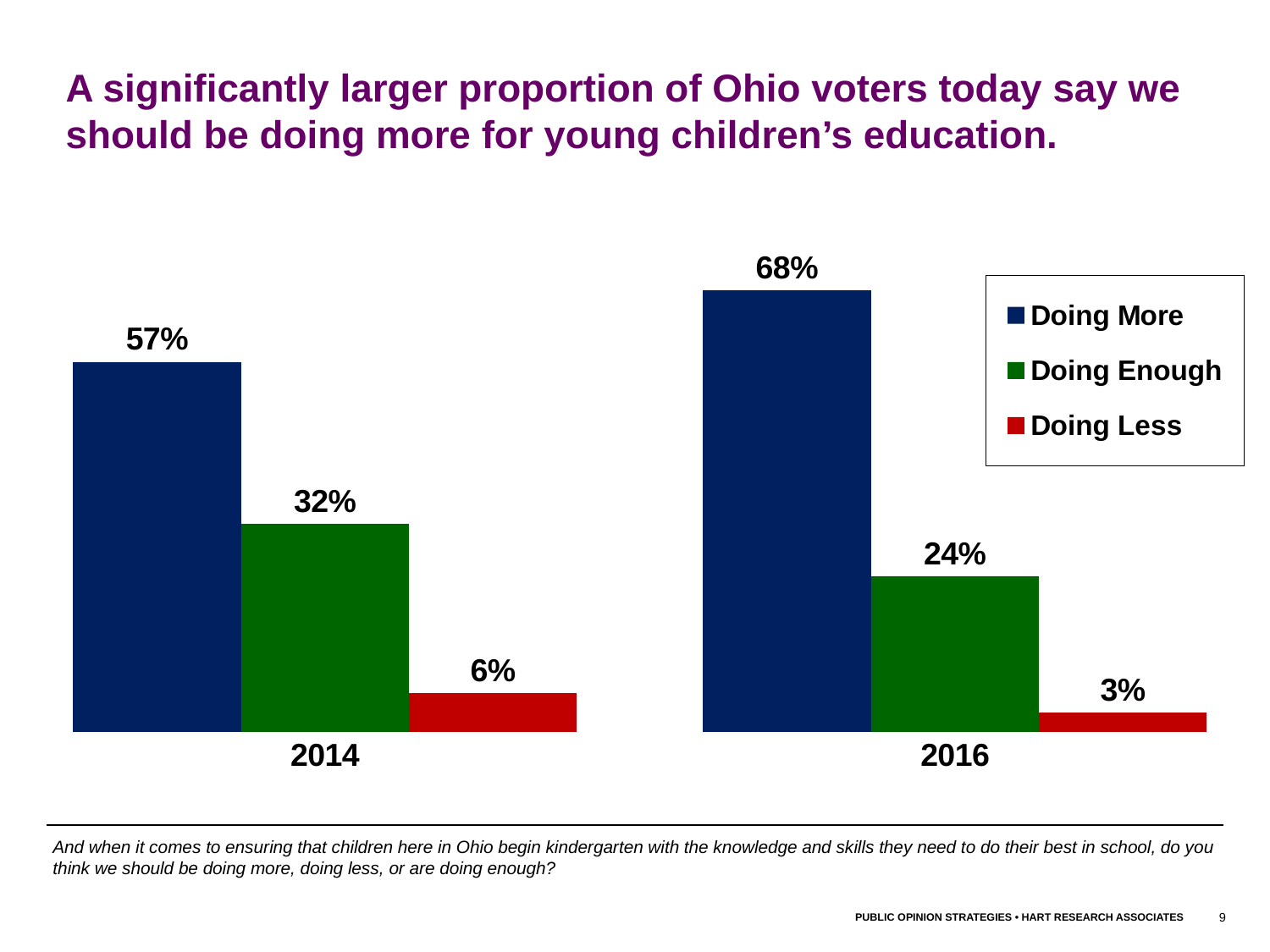
Which response had the highest percentage in 2014? Doing More How many years are shown on the x axis? 2 By how many percentage points did "Doing More" increase from 2014 to 2016? 11 What kind of chart is shown on the slide? Bar chart What colour represents "Doing Enough" in the legend? Green How many series does the legend list? 3 Which response had the lowest percentage in 2016? Doing Less What percentage of Ohio voters said "Doing More" in 2016? 68% Which is larger: "Doing Less" in 2014 or "Doing Less" in 2016? Doing Less in 2014 What percentage of Ohio voters said "Doing Less" in 2016? 3% What percentage of Ohio voters said "Doing Enough" in 2014? 32% What is the difference between "Doing Enough" in 2014 and "Doing Enough" in 2016? 8